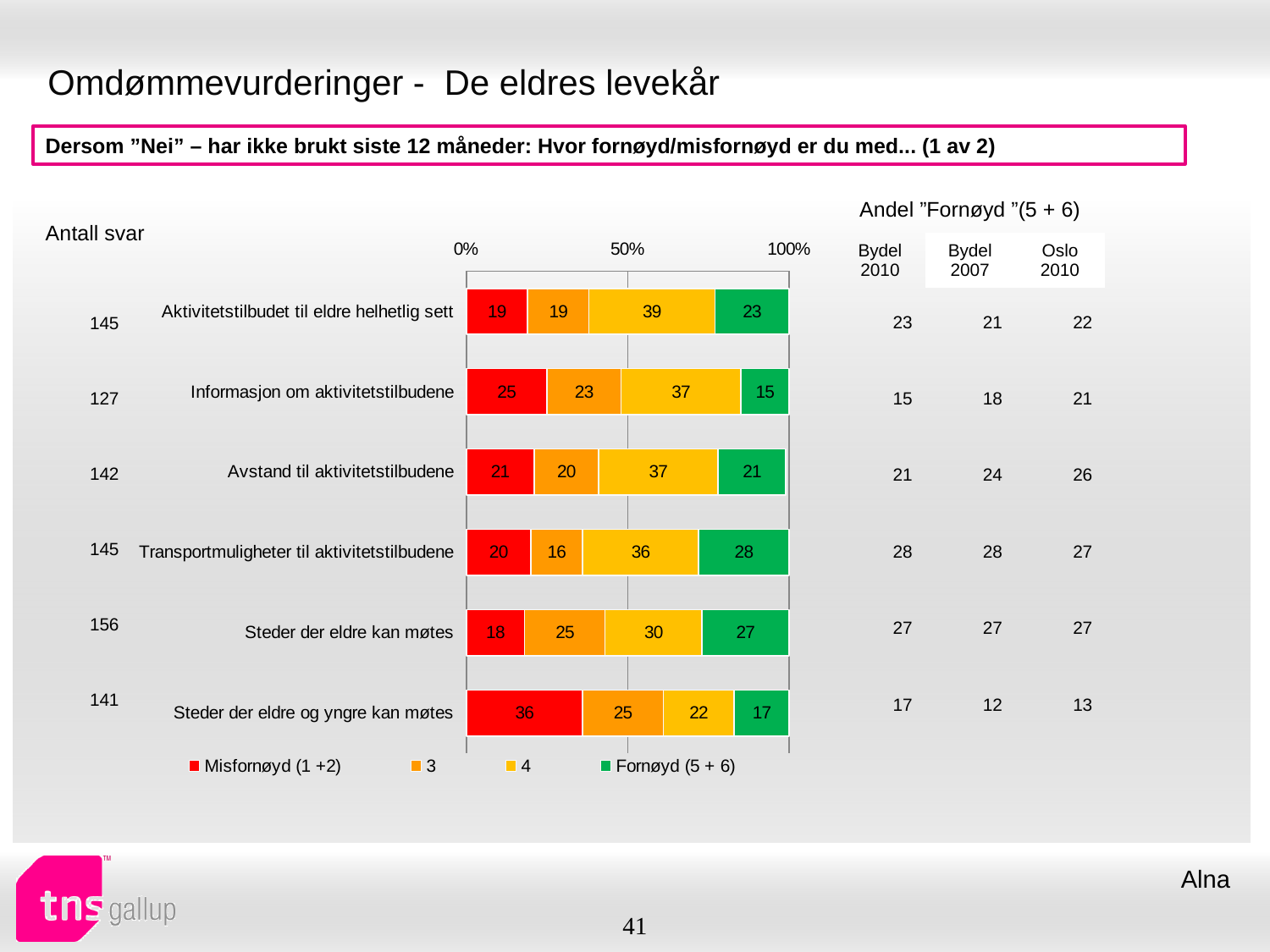
How many series does the chart legend list? 4 Which colour represents 'Fornøyd (5 + 6)' in the chart? green What kind of chart is shown on the slide? stacked bar chart What is the value of 'Misfornøyd (1 +2)' for 'Steder der eldre og yngre kan møtes'? 36 What is the difference between the 'Fornøyd (5 + 6)' values for 'Transportmuligheter til aktivitetstilbudene' and 'Informasjon om aktivitetstilbudene'? 13 What is the value of 'Fornøyd (5 + 6)' for 'Transportmuligheter til aktivitetstilbudene'? 28 What is the value of series '4' for 'Aktivitetstilbudet til eldre helhetlig sett'? 39 Which category has the highest 'Misfornøyd (1 +2)' value? Steder der eldre og yngre kan møtes Which category has the lowest 'Fornøyd (5 + 6)' value? Informasjon om aktivitetstilbudene What is the total of the stacked bar for 'Steder der eldre kan møtes'? 100 Which is larger: the 'Misfornøyd (1 +2)' value for 'Informasjon om aktivitetstilbudene' or for 'Steder der eldre kan møtes'? Informasjon om aktivitetstilbudene How many categories are plotted in the chart? 6